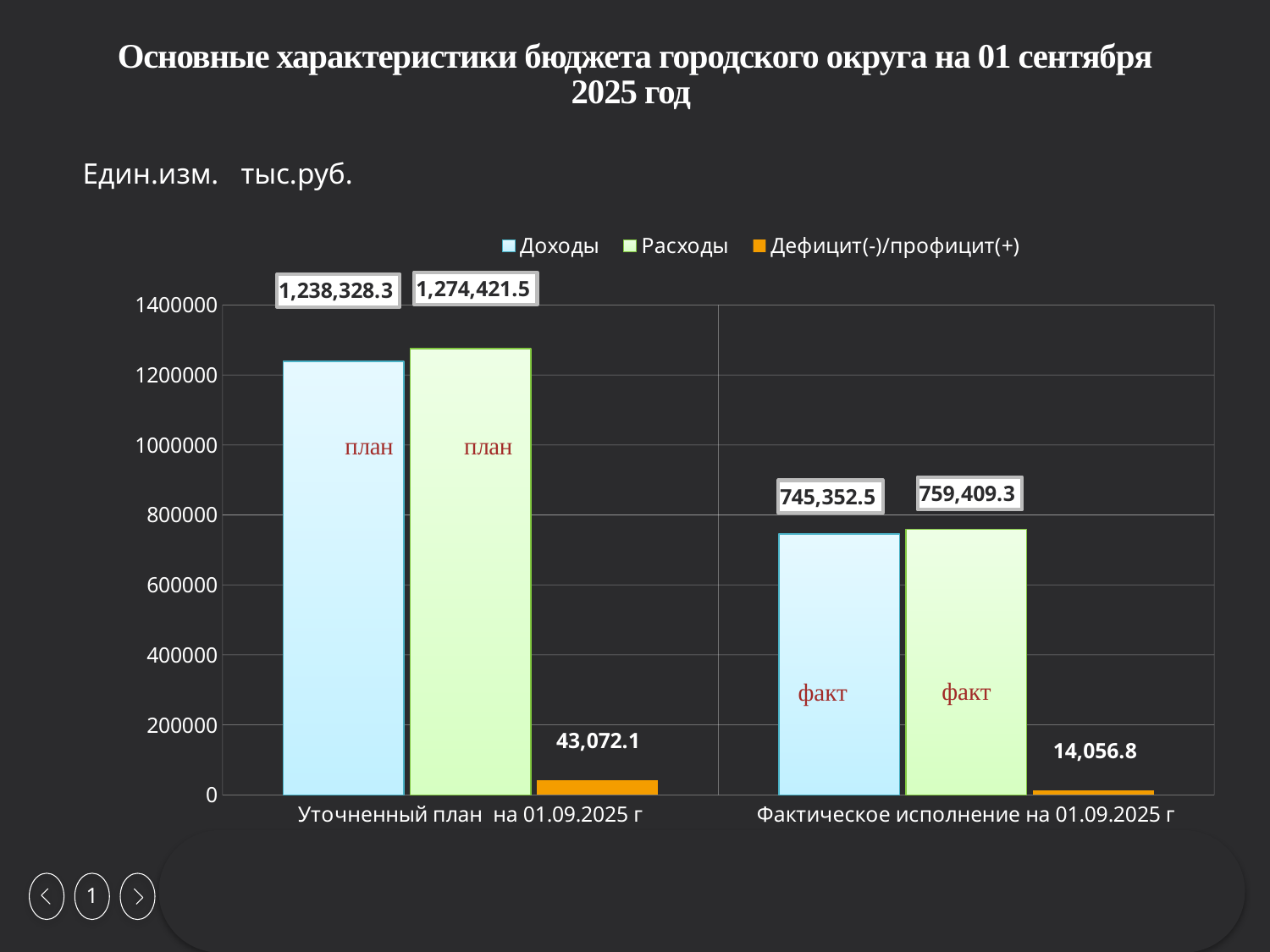
What type of chart is shown on the slide? bar chart Which is larger: Доходы for Уточненный план на 01.09.2025 г or Доходы for Фактическое исполнение на 01.09.2025 г? Уточненный план на 01.09.2025 г Which series has the lowest value for Фактическое исполнение на 01.09.2025 г? Дефицит(-)/профицит(+) What is the value of Расходы for Уточненный план на 01.09.2025 г? 1,274,421.5 What is the value of Доходы for Уточненный план на 01.09.2025 г? 1,238,328.3 How many series does the legend list? 3 What unit of measurement is stated on the slide for the chart values? тыс.руб. What is the difference between Расходы and Доходы for Уточненный план на 01.09.2025 г? 36,093.2 What is the value of Дефицит(-)/профицит(+) for Фактическое исполнение на 01.09.2025 г? 14,056.8 Which series has the highest value for Уточненный план на 01.09.2025 г? Расходы What is the value of Расходы for Фактическое исполнение на 01.09.2025 г? 759,409.3 How many categories are shown on the x axis? 2